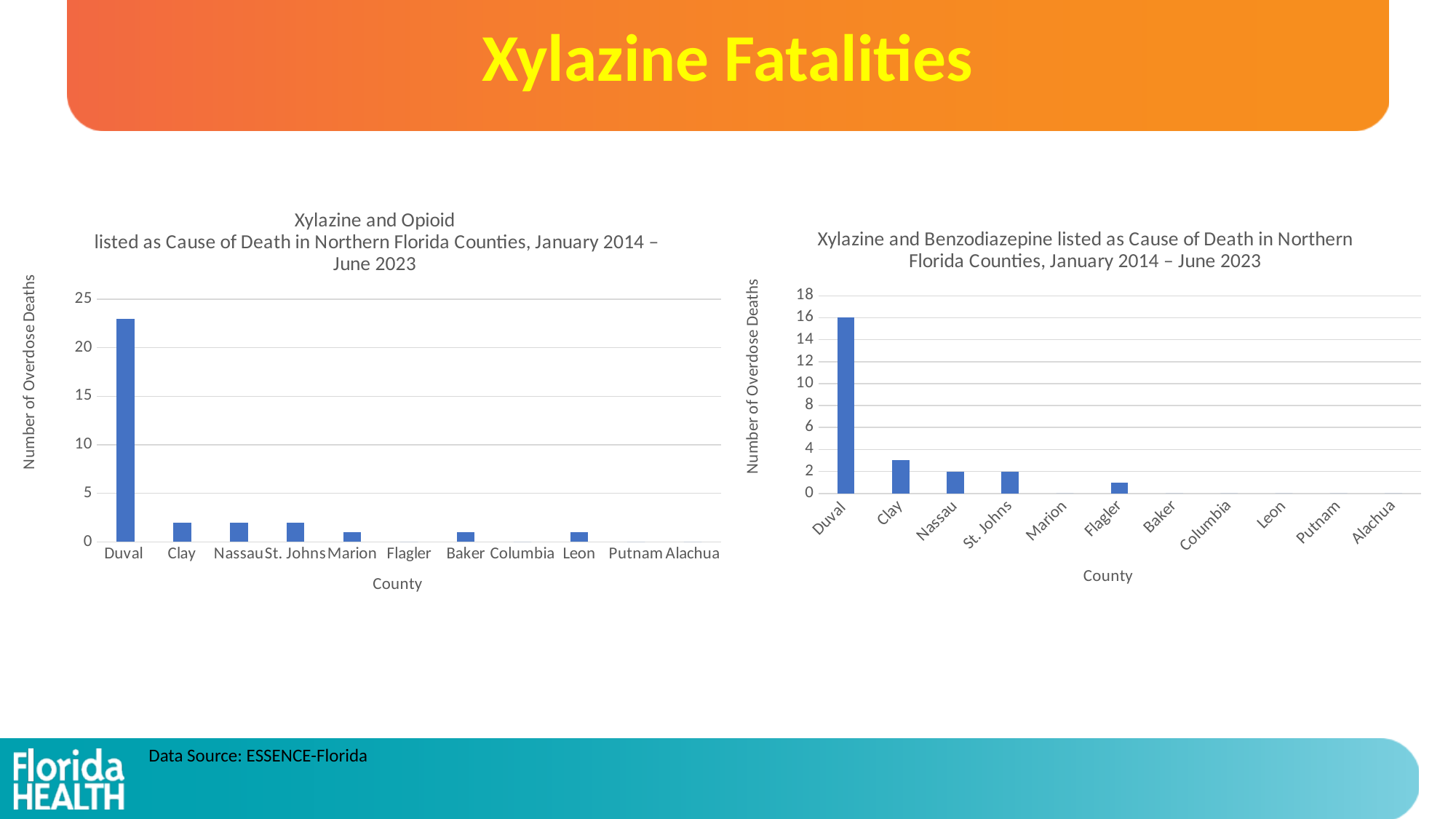
What is the y-axis title of the left chart (Xylazine and Opioid)? Number of Overdose Deaths In the right chart (Xylazine and Benzodiazepine), what is the difference between the values for Duval and St. Johns? 14 In the right chart (Xylazine and Benzodiazepine), which county has the highest number of overdose deaths? Duval In the left chart (Xylazine and Opioid), which is larger, the value for Duval or the value for Nassau? Duval What kind of chart is the right chart (Xylazine and Benzodiazepine)? Bar chart In the right chart (Xylazine and Benzodiazepine), what is the number of overdose deaths for Duval? 16 In the left chart (Xylazine and Opioid), which county has the highest number of overdose deaths? Duval In the left chart (Xylazine and Opioid), is the value for Clay greater or less than 5? less In the left chart (Xylazine and Opioid), is the value for Duval greater or less than 20? greater How many counties are shown on the x axis of the left chart (Xylazine and Opioid)? 11 In the right chart (Xylazine and Benzodiazepine), is the value for Clay greater or less than 2? greater In the right chart (Xylazine and Benzodiazepine), what is the number of overdose deaths for Nassau? 2